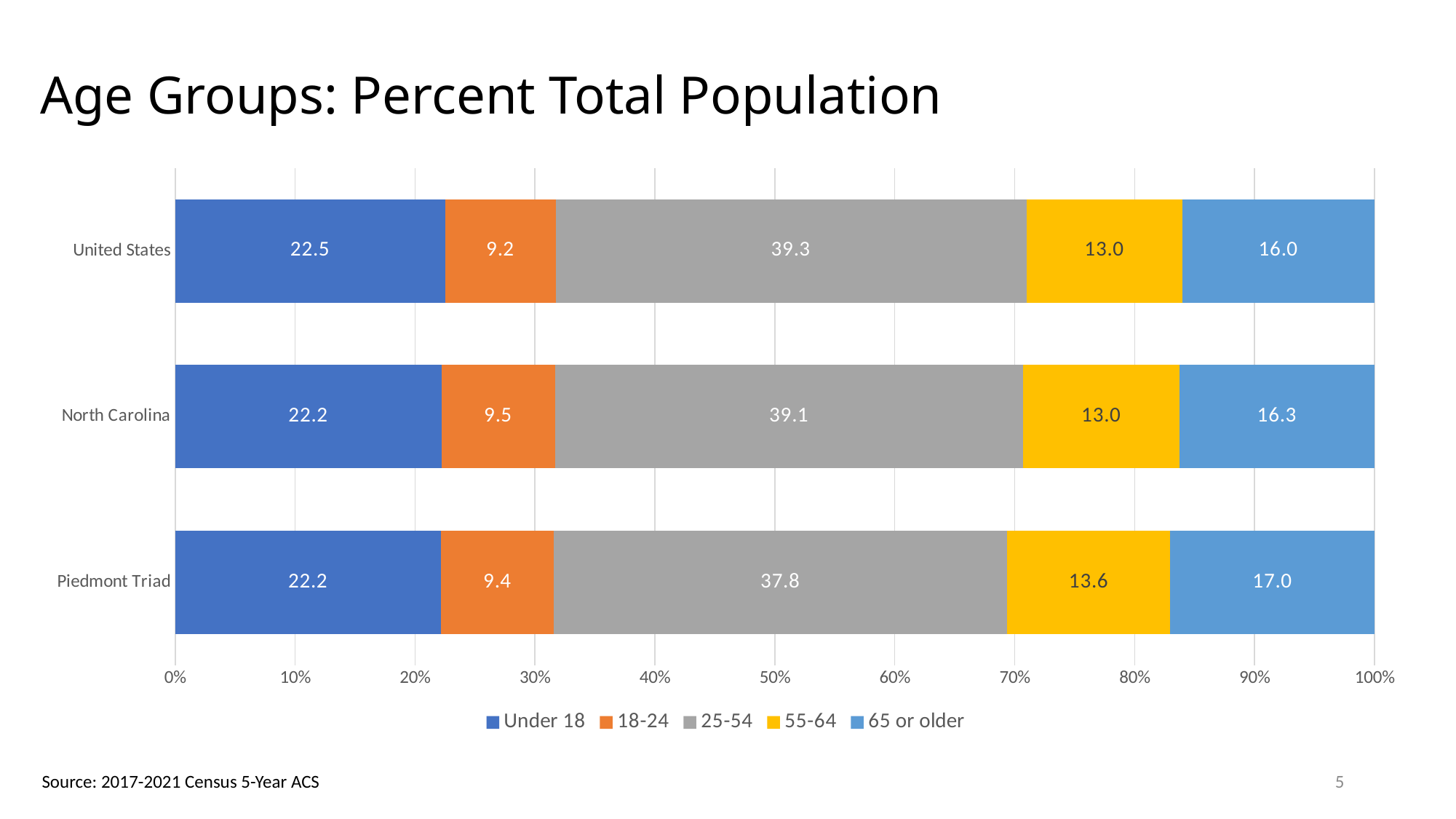
What is the title of the chart? Age Groups: Percent Total Population What kind of chart is shown on the slide? Stacked bar chart What is the value for the 65 or older age group in the Piedmont Triad? 17.0 Which is larger: the Under 18 value for the United States or for North Carolina? United States What is the total of the stacked bar for the Piedmont Triad? 100.0 What is the value for the 18-24 age group in North Carolina? 9.5 How many age groups does the legend list? 5 Which region has the highest value for the 65 or older age group? Piedmont Triad How many regions are shown on the chart? 3 What is the difference between the 25-54 values for the United States and the Piedmont Triad? 1.5 What is the value for the 25-54 age group in the United States? 39.3 Which region has the lowest value for the 25-54 age group? Piedmont Triad